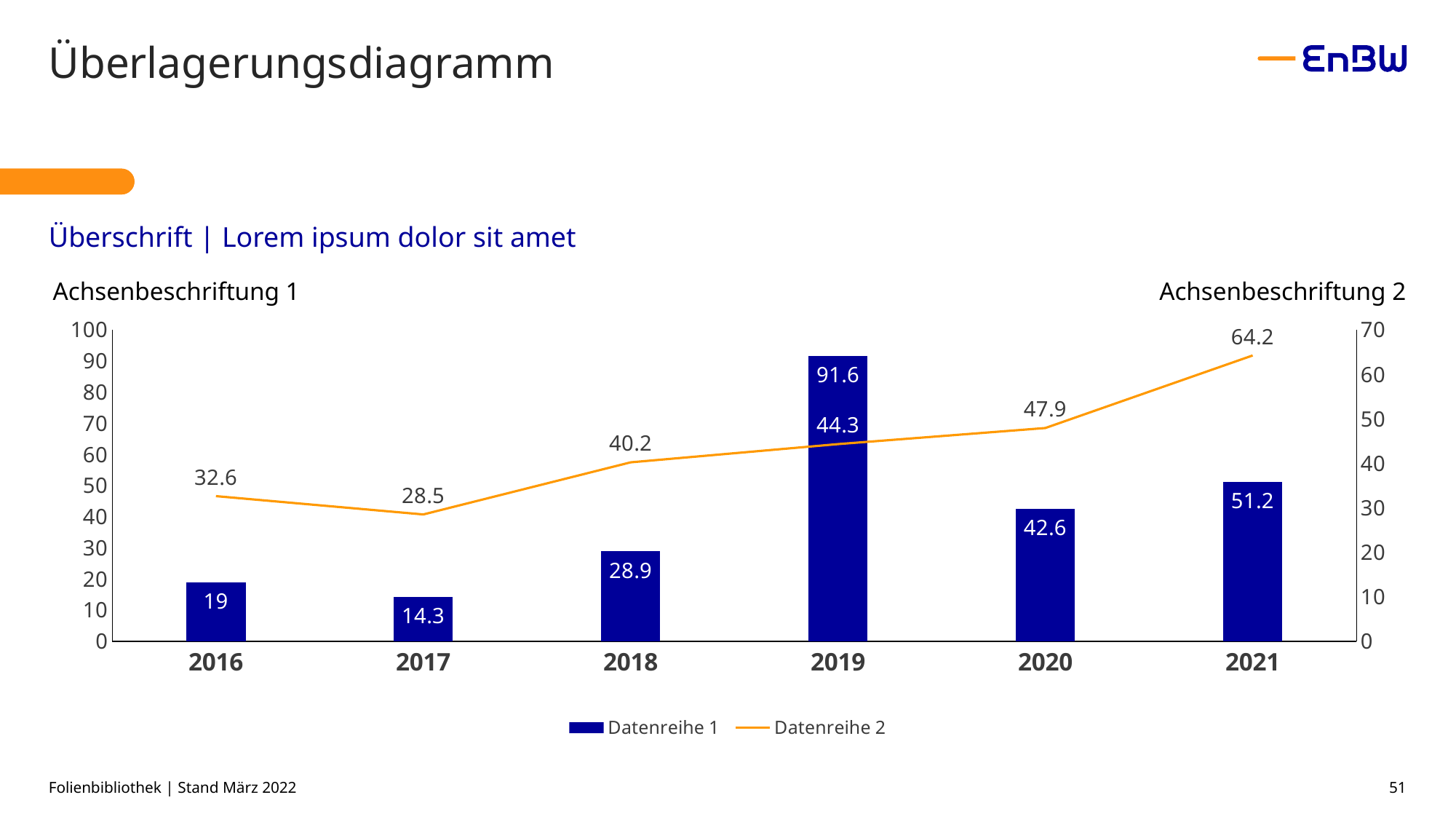
What is the value of Datenreihe 2 for 2021? 64.2 How many series does the legend list? 2 What is the value of Datenreihe 1 for 2017? 14.3 What is the value of Datenreihe 2 for 2016? 32.6 How many years are shown on the x axis? 6 Does Datenreihe 2 rise or fall from 2017 to 2021? Rise What is the value of Datenreihe 1 for 2019? 91.6 What is the difference between the Datenreihe 1 values for 2021 and 2020? 8.6 Which year has the highest value for Datenreihe 1? 2019 What kind of chart is shown on the slide? Combined bar and line chart Which is larger: the Datenreihe 1 value for 2018 or for 2020? 2020 Which year has the lowest value for Datenreihe 2? 2017